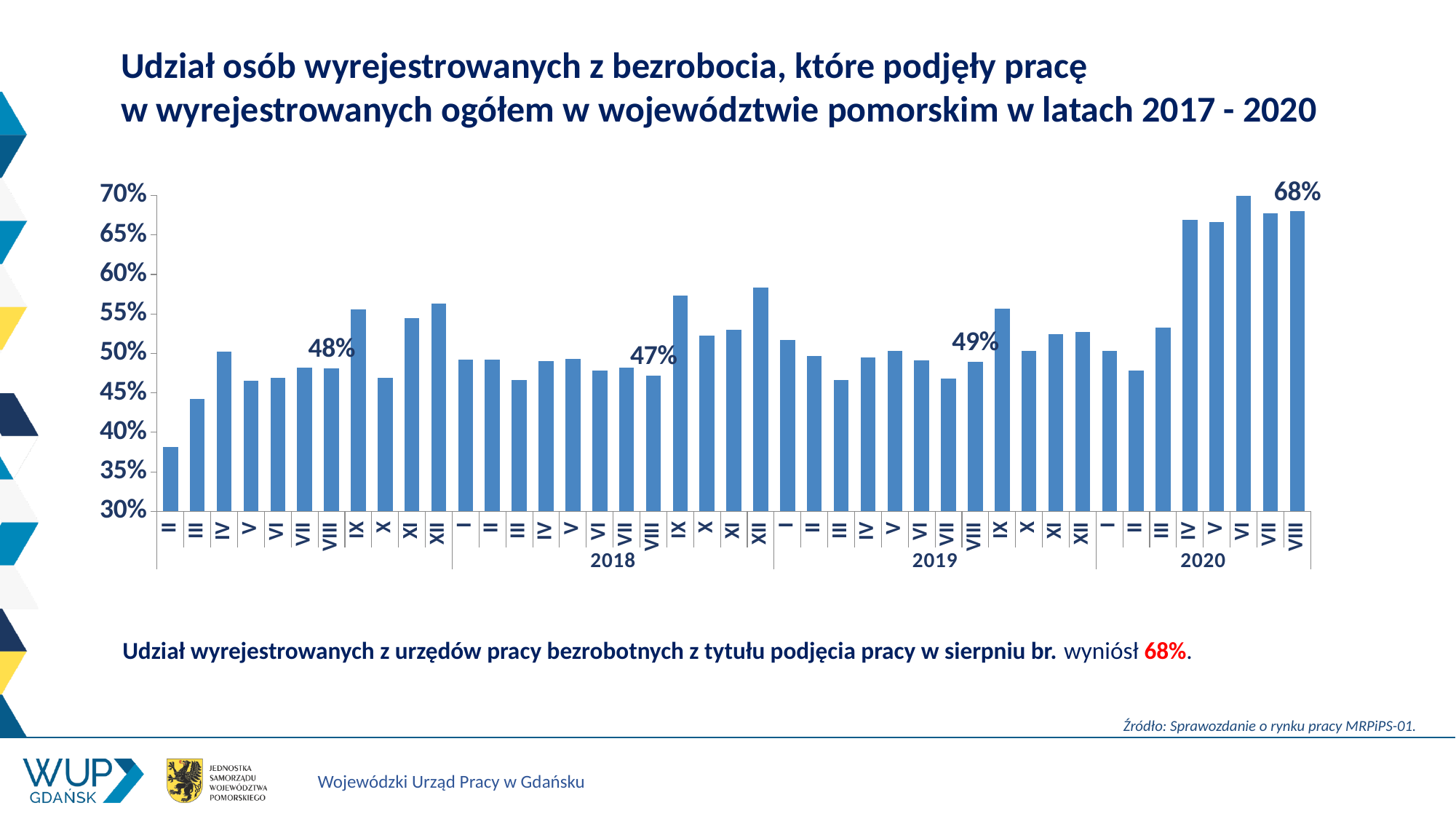
What is the value for VIII 2019 (August 2019)? 49% Which month has the highest bar on the chart? VI 2020 Is the value for XII 2018 greater or less than 55%? greater What is the difference between the labelled values for VIII 2020 and VIII 2017? 20 percentage points What kind of chart is shown on the slide? bar chart Which month has the lowest bar on the chart? II 2017 Do the values rise or fall from I 2020 to VI 2020? rise Which is larger, the value for VIII 2019 or the value for VIII 2020? VIII 2020 What is the value for VIII 2020 (August 2020)? 68% Is the value for II 2017 greater or less than 40%? less What is the value for VIII 2018 (August 2018)? 47% What is the value for VIII 2017 (August 2017)? 48%